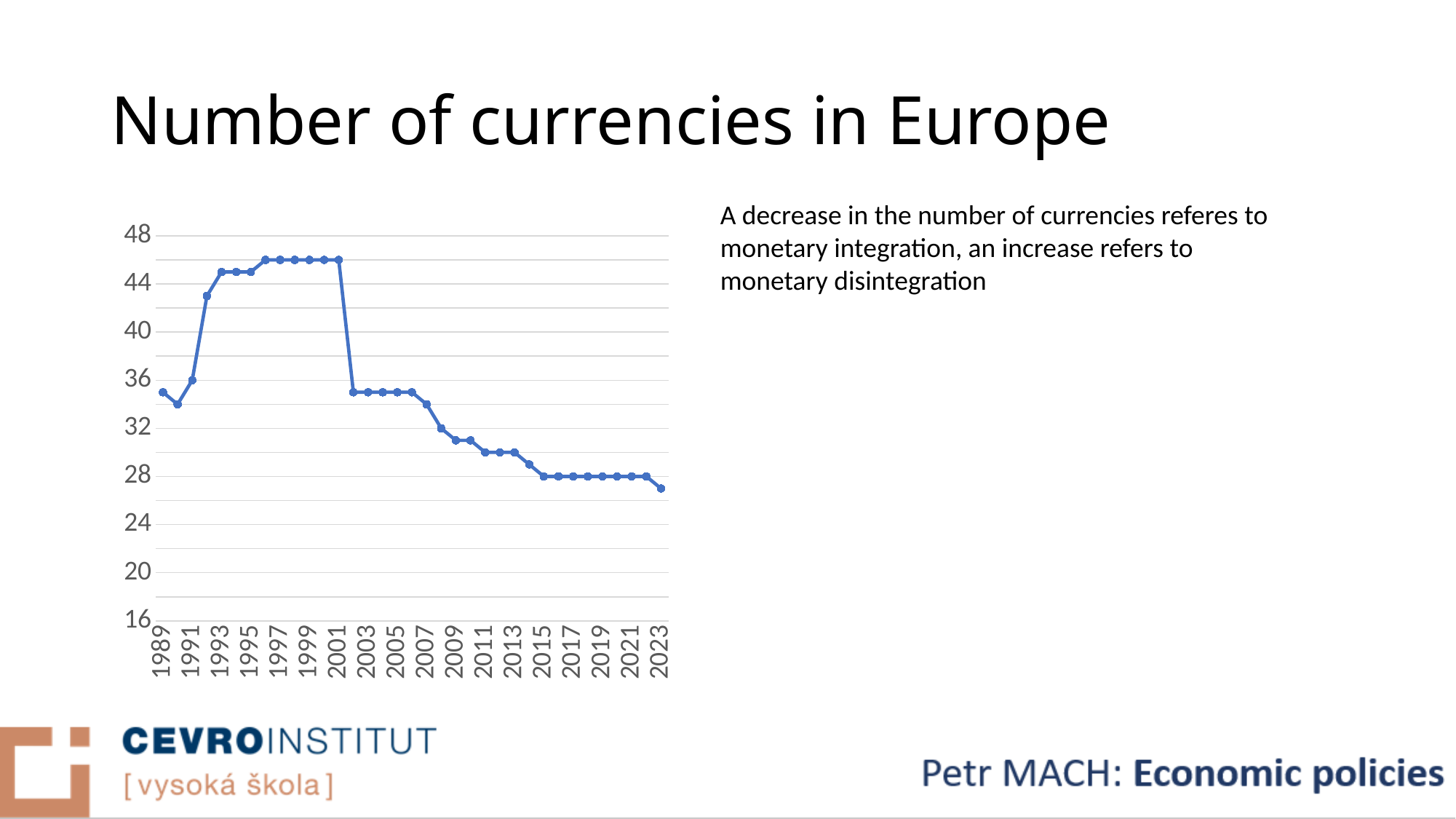
What is the value for 1991? 36 What is the title of the slide containing the chart? Number of currencies in Europe How many year labels are shown on the x axis? 18 Is the value for 1997 greater or less than 44? greater Is the value for 1993 greater or less than 40? greater Which year has the lowest value on the chart? 2023 What is the value for 2017? 28 Which is larger, the value for 1997 or the value for 2003? 1997 Is the value for 2003 greater or less than 40? less Do the values rise or fall from 2001 to 2023? fall What kind of chart is shown on the slide? line chart